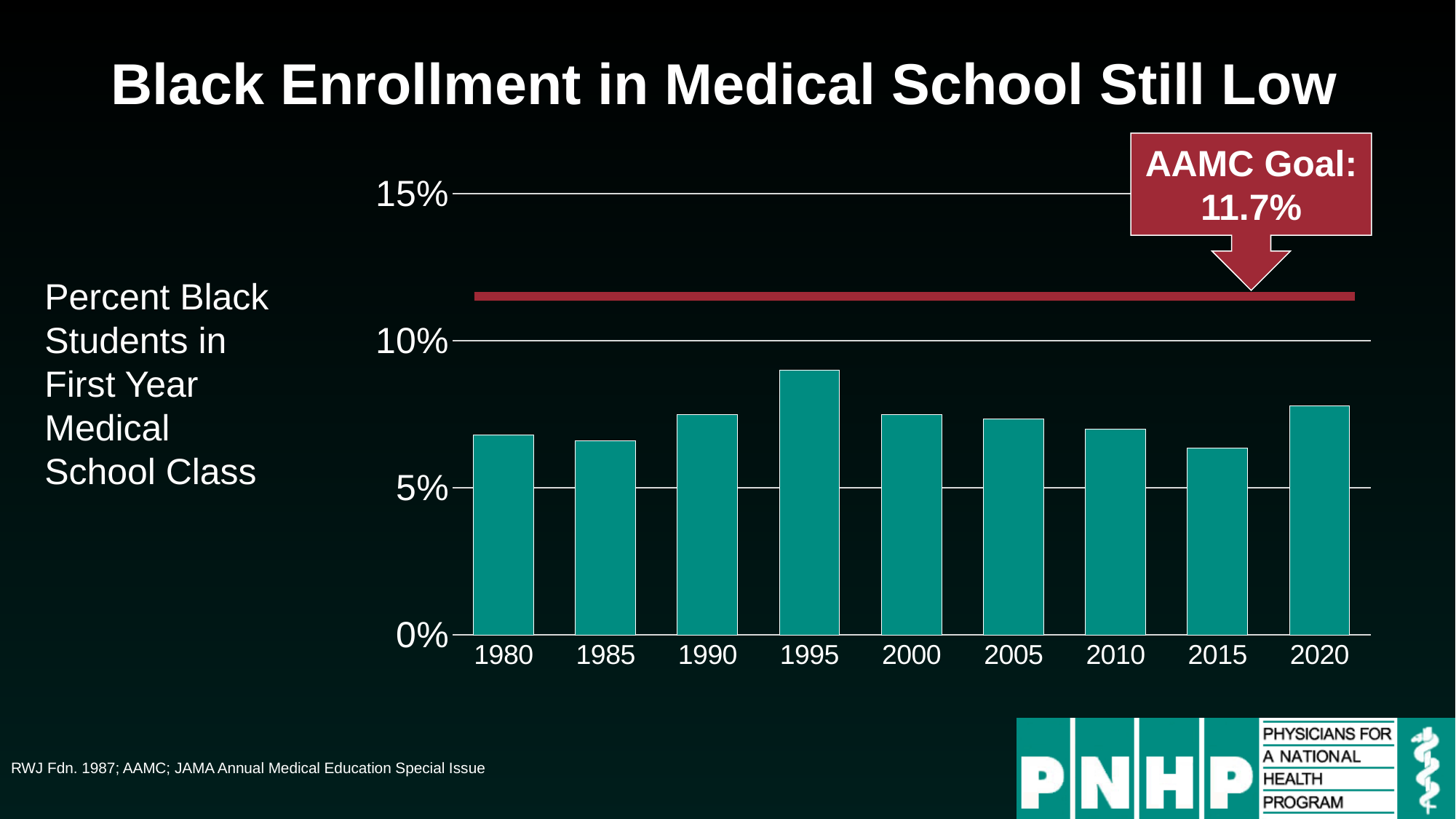
Which year has the highest percent of Black students in the first year medical school class? 1995 Which is larger, the value for 1980 or the value for 1995? 1995 Which year has the lowest percent of Black students in the first year medical school class? 2015 Is the value for 1995 greater or less than 10%? less Which is larger, the value for 1995 or the value for 2020? 1995 What is the title of the slide containing the chart? Black Enrollment in Medical School Still Low What is the AAMC goal shown by the red line on the chart? 11.7% Which is larger, the value for 2015 or the value for 2020? 2020 How many years (bars) are plotted on the chart? 9 Is the value for 2015 greater or less than 5%? greater Is the value for 2020 greater or less than 10%? less What kind of chart is shown on the slide? bar chart